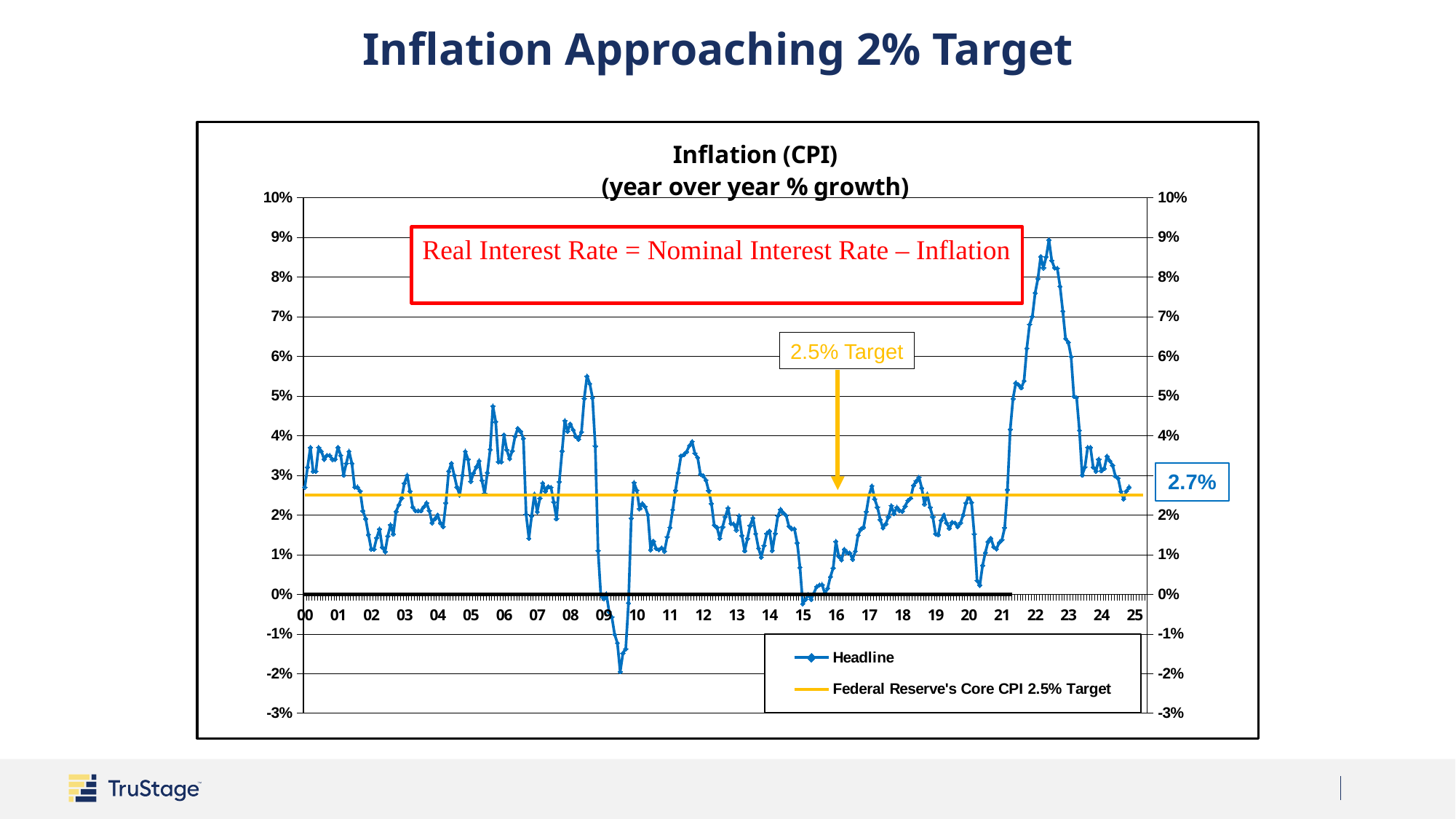
How many series does the chart's legend list? 2 What value does the Federal Reserve's Core CPI target line sit at? 2.5% What is the most recent Headline inflation value labeled on the chart? 2.7% Which is higher: the Headline peak in 2008 or the Headline peak in 2022? 2022 What are the two series named in the legend? Headline; Federal Reserve's Core CPI 2.5% Target Is the peak Headline inflation value in 2022 greater or less than 8%? greater In which year does the Headline series reach its lowest value? 2009 What kind of chart is shown on the slide? Line chart Is the lowest Headline inflation value in 2009 greater or less than -1%? less In which year does the Headline series reach its highest value? 2022 Does the Headline series rise or fall from its 2022 peak to 2025? Fall What formula is written in the red box on the chart? Real Interest Rate = Nominal Interest Rate – Inflation